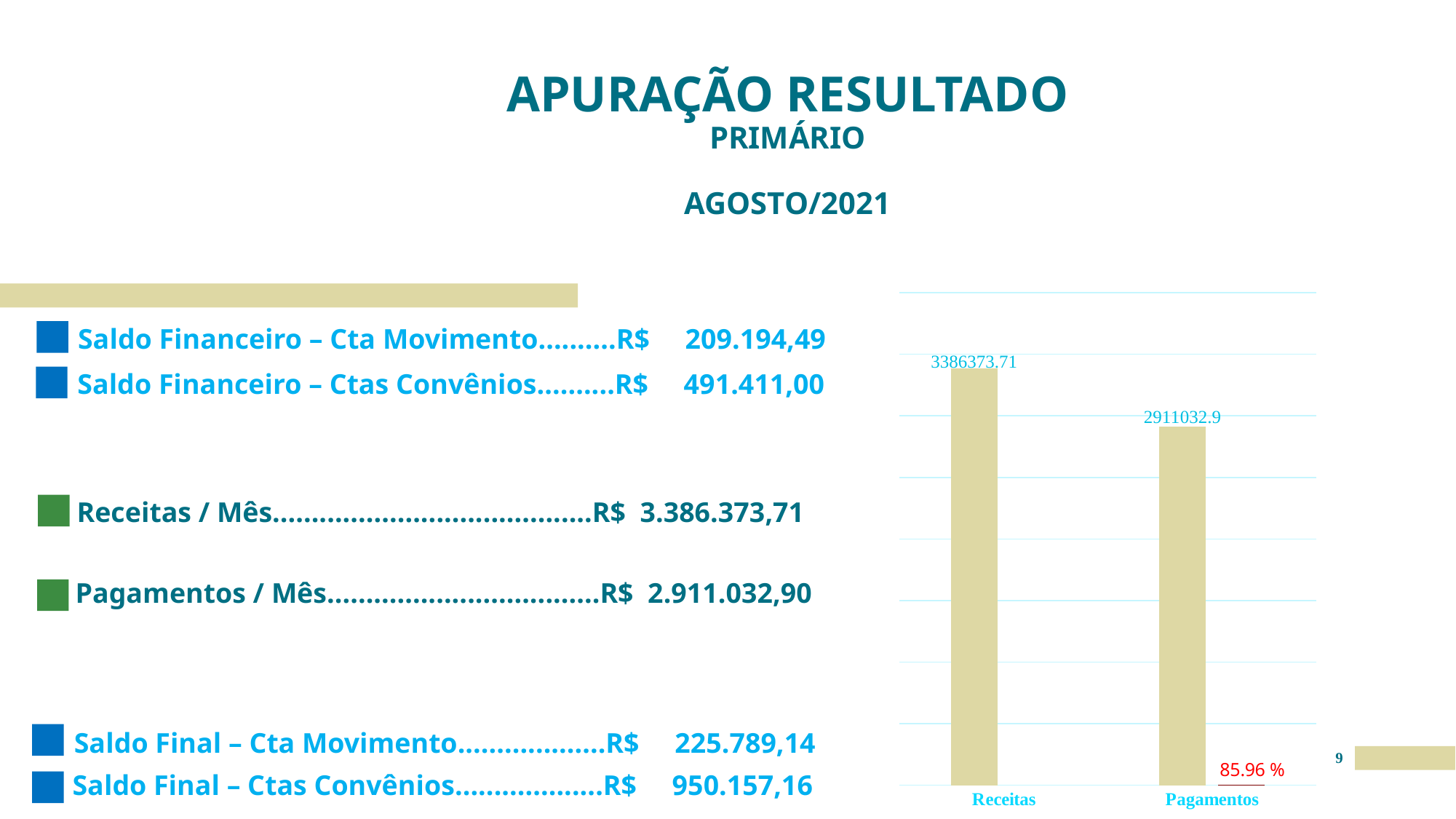
Is the bar for Receitas larger or smaller than the bar for Pagamentos? larger What is the value shown for Receitas in the bar chart? 3386373.71 How many bars are plotted in the chart? 2 Which category has the lowest bar in the chart? Pagamentos What type of chart is shown on the slide? bar chart Which category has the highest bar in the chart? Receitas What is the difference between the Receitas and Pagamentos values in the chart? 475340.81 What percentage label is printed in red next to the Pagamentos bar? 85.96 % What are the two category labels on the x axis of the chart? Receitas and Pagamentos What is the value shown for Pagamentos in the bar chart? 2911032.9